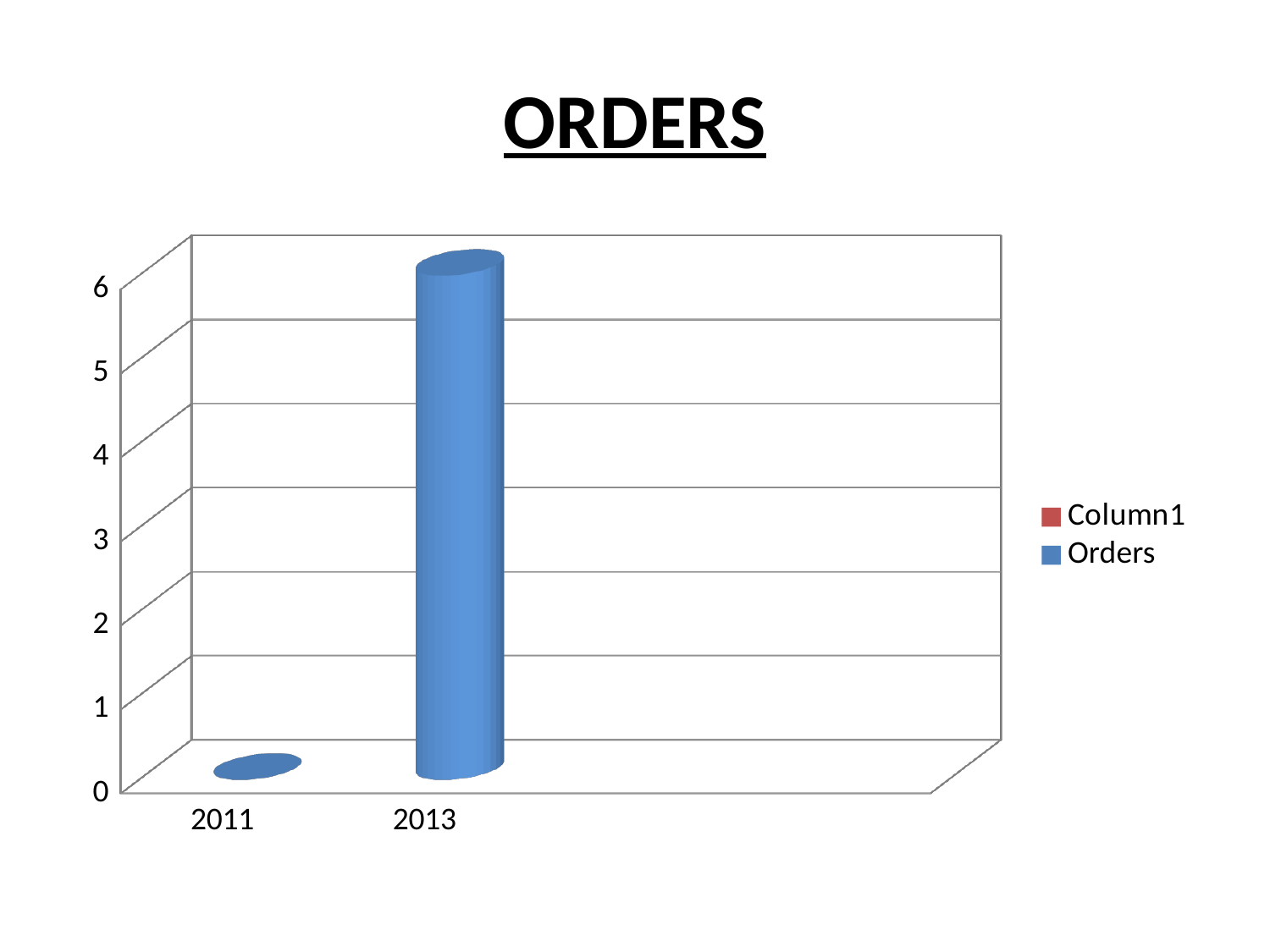
Is the value for 2013 greater or less than 5? greater How many series does the legend list? 2 Which is larger, the value for 2011 or the value for 2013? 2013 What kind of chart is shown on the slide? bar chart What is the title of the chart? ORDERS How many categories are shown on the x axis? 2 Is the value for 2011 greater or less than 1? less Which category has the lowest value? 2011 Which category has the highest value? 2013 Do the values rise or fall from 2011 to 2013? rise What are the two entries listed in the legend? Column1 and Orders